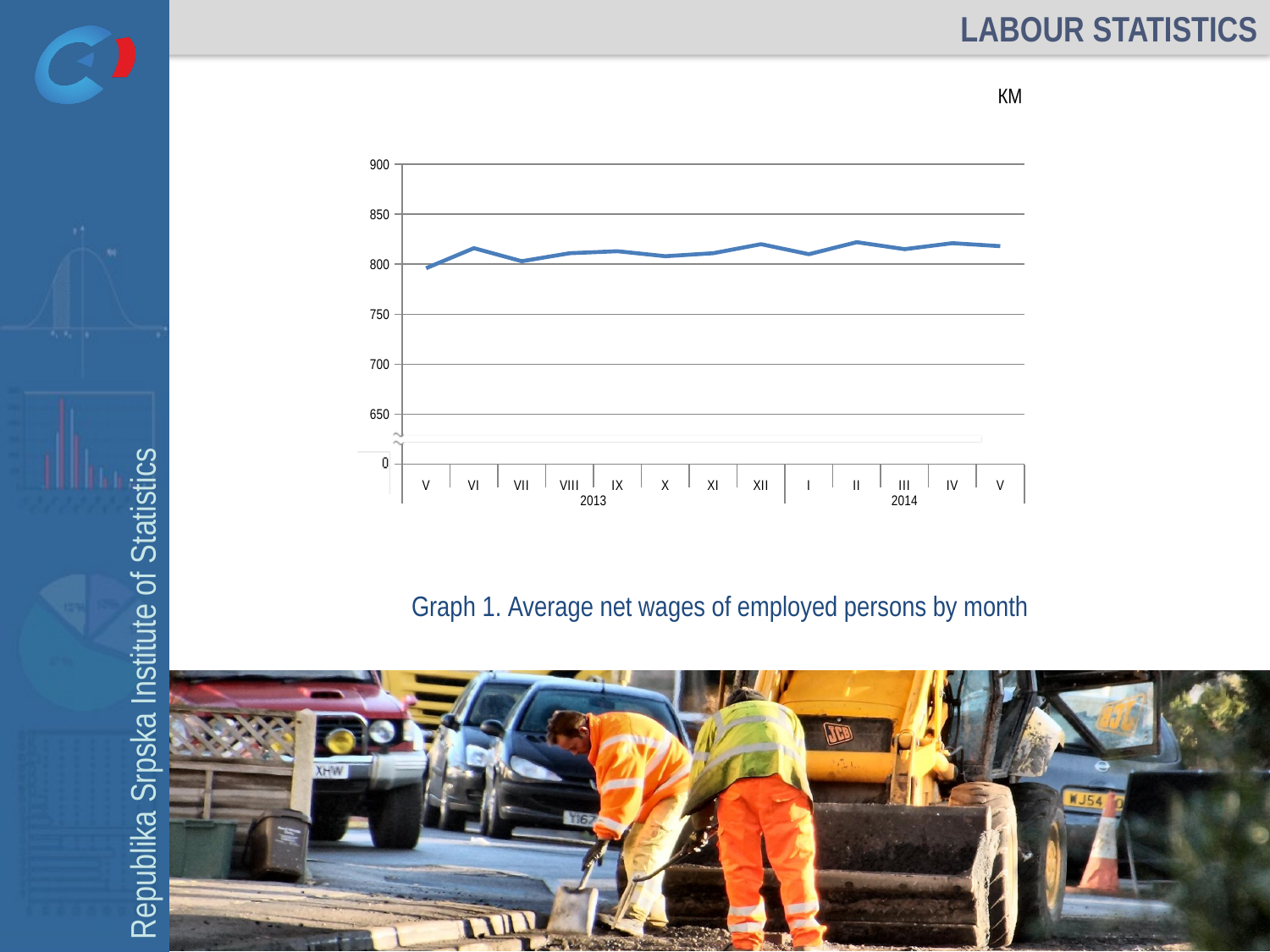
How many monthly data points are plotted on the chart? 13 Is the value for I 2014 greater or less than 750? greater Which is larger, the value for VII 2013 or the value for XII 2013? XII 2013 What is the title of the chart on the slide? Graph 1. Average net wages of employed persons by month Which is larger, the value for V 2013 or the value for VI 2013? VI 2013 Overall, do the average net wages rise or fall from V 2013 to V 2014? rise What unit is indicated for the values in the chart? KM Is the value for XII 2013 greater or less than 850? less Is the value for II 2014 greater or less than 800? greater What kind of chart is shown on the slide? line chart Which month has the lowest average net wage on the chart? V 2013